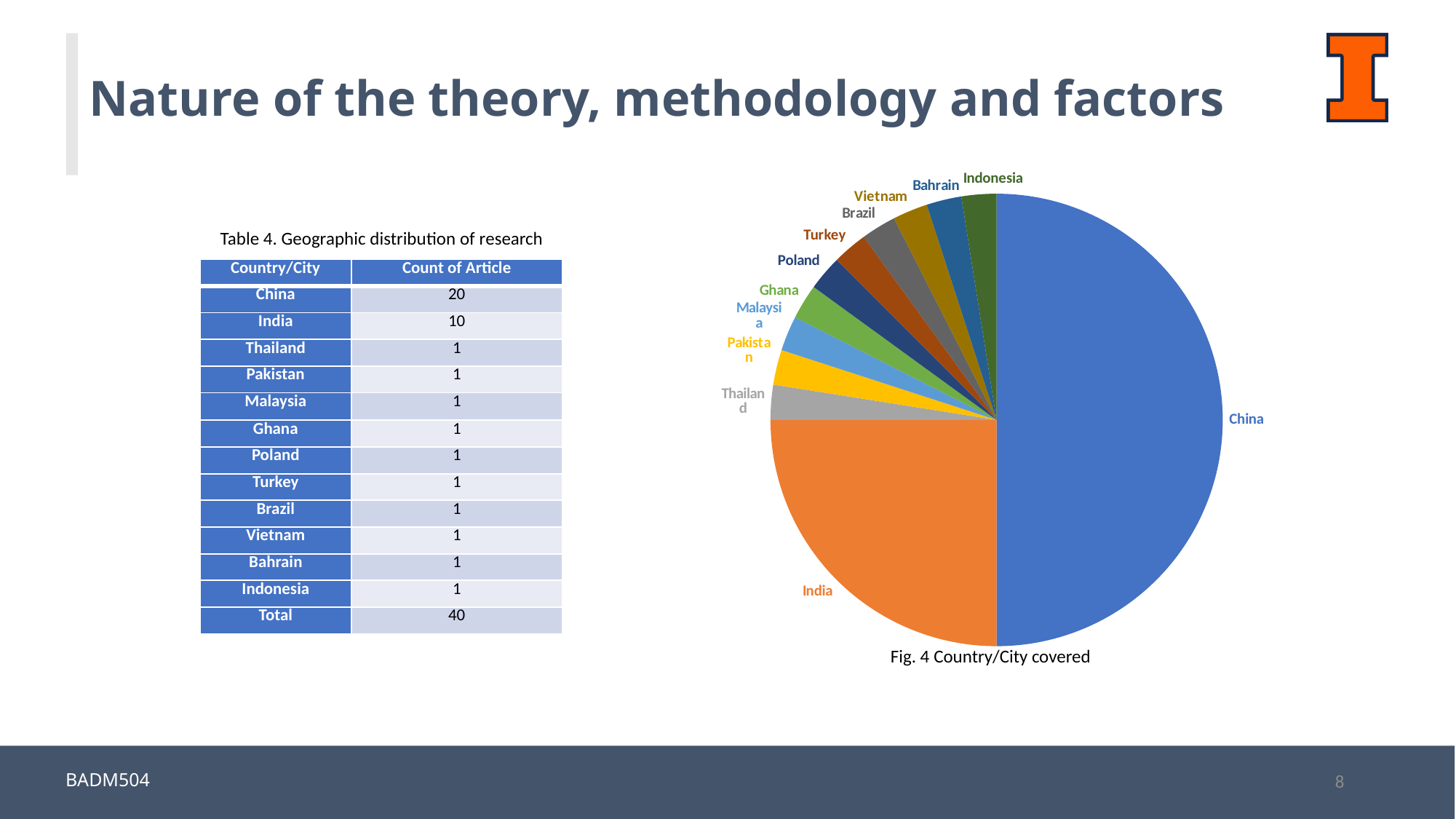
In the pie chart, which slice is larger, India or Thailand? India According to the slide, how many articles does the China slice of the pie chart represent? 20 In the pie chart, which slice is larger, China or India? China What is the difference in article count between the China and India slices? 10 What kind of chart is Fig. 4 Country/City covered? pie chart What share of the pie does China's slice represent? 50% What is the caption of the pie chart? Fig. 4 Country/City covered How many slices does the pie chart have? 12 What share of the pie does India's slice represent? 25% According to the slide, how many articles does the India slice of the pie chart represent? 10 In the pie chart, which country has the largest slice? China What colour is the India slice in the pie chart? orange